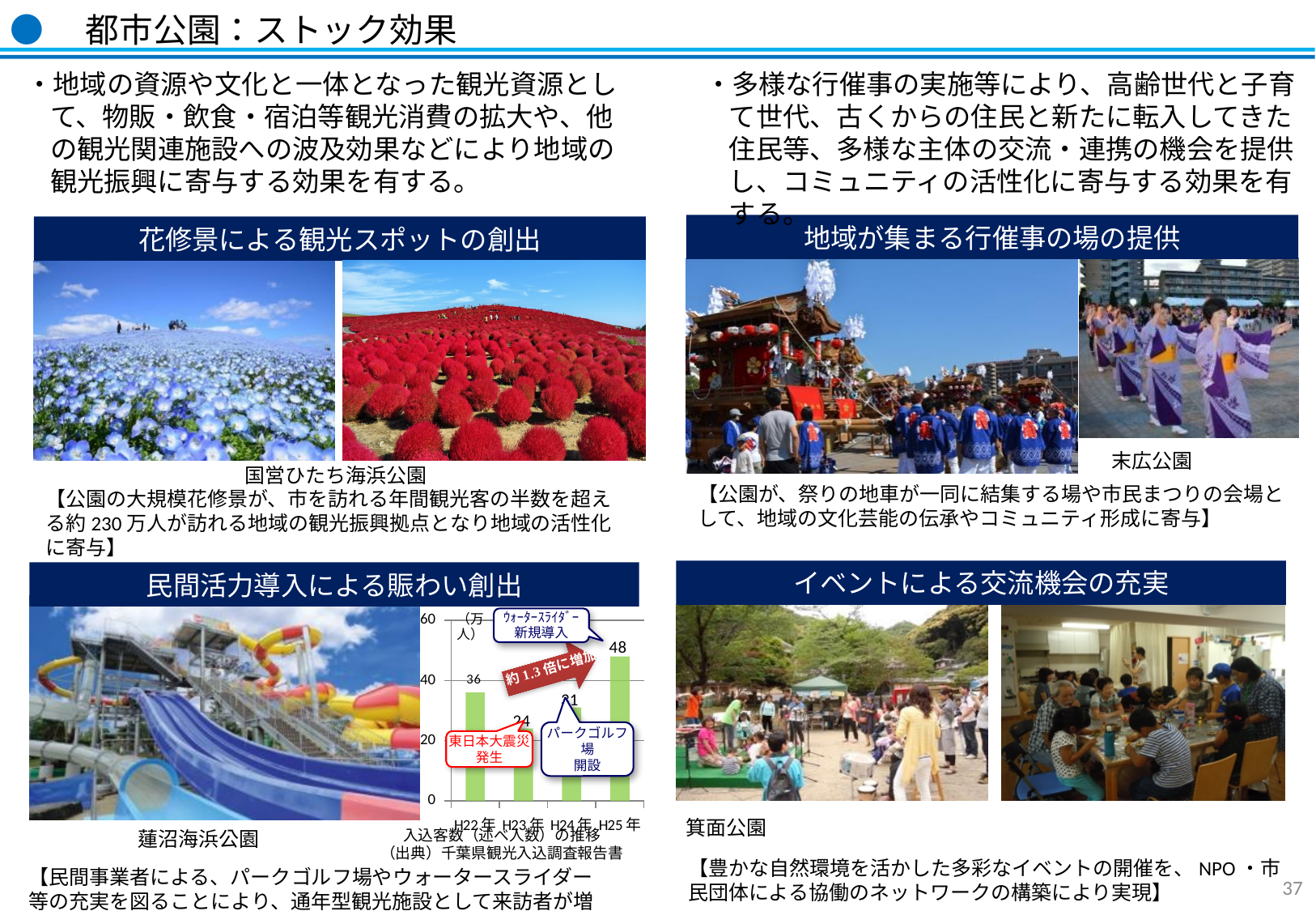
What is the value for H25年 in the bar chart? 48 Is the value for H24年 greater or less than 40? less Which year has the highest value in the bar chart? H25年 What is the value for H22年 in the bar chart? 36 What is the difference between the values for H25年 and H22年? 12 What is the value for H23年 in the bar chart? 24 What is the difference between the values for H22年 and H23年? 12 How many years are shown on the x axis of the bar chart? 4 Which is larger, the value for H22年 or the value for H25年? H25年 Which year has the lowest value in the bar chart? H23年 What unit is shown on the y axis of the bar chart? 万人 What kind of chart is shown on the slide? bar chart